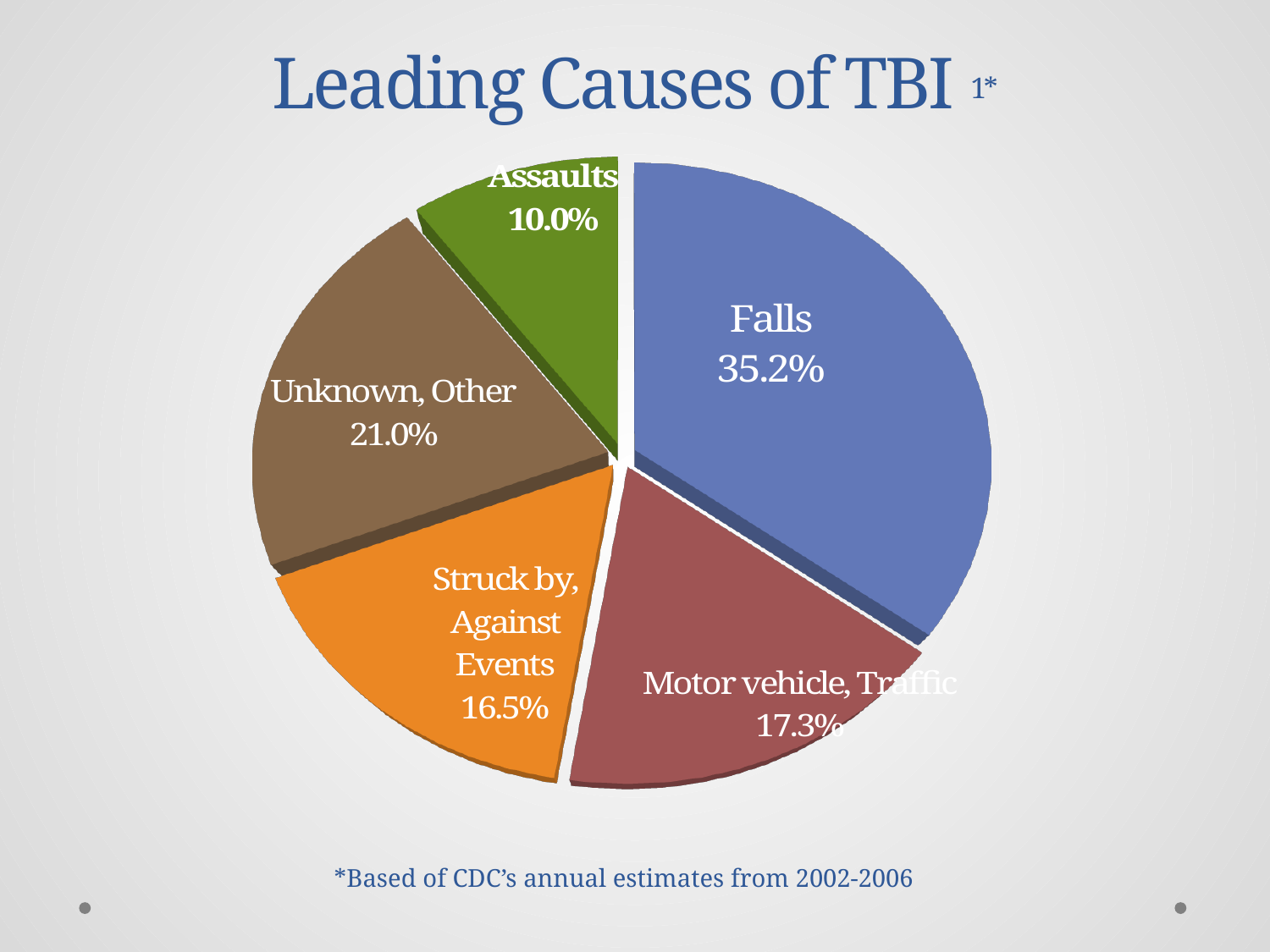
Which cause has the largest share of the pie? Falls What percentage is shown for Assaults? 10.0% What percentage is shown for Unknown, Other? 21.0% What percentage is shown for Motor vehicle, Traffic? 17.3% What type of chart is shown on the slide? pie chart What is the difference in percentage points between Falls and Unknown, Other? 14.2 How many slices does the pie chart have? 5 What percentage is shown for Struck by, Against Events? 16.5% What percentage of TBI cases is attributed to Falls? 35.2% What is the title of the chart? Leading Causes of TBI Which is larger, the share for Unknown, Other or the share for Motor vehicle, Traffic? Unknown, Other Which cause has the smallest share of the pie? Assaults